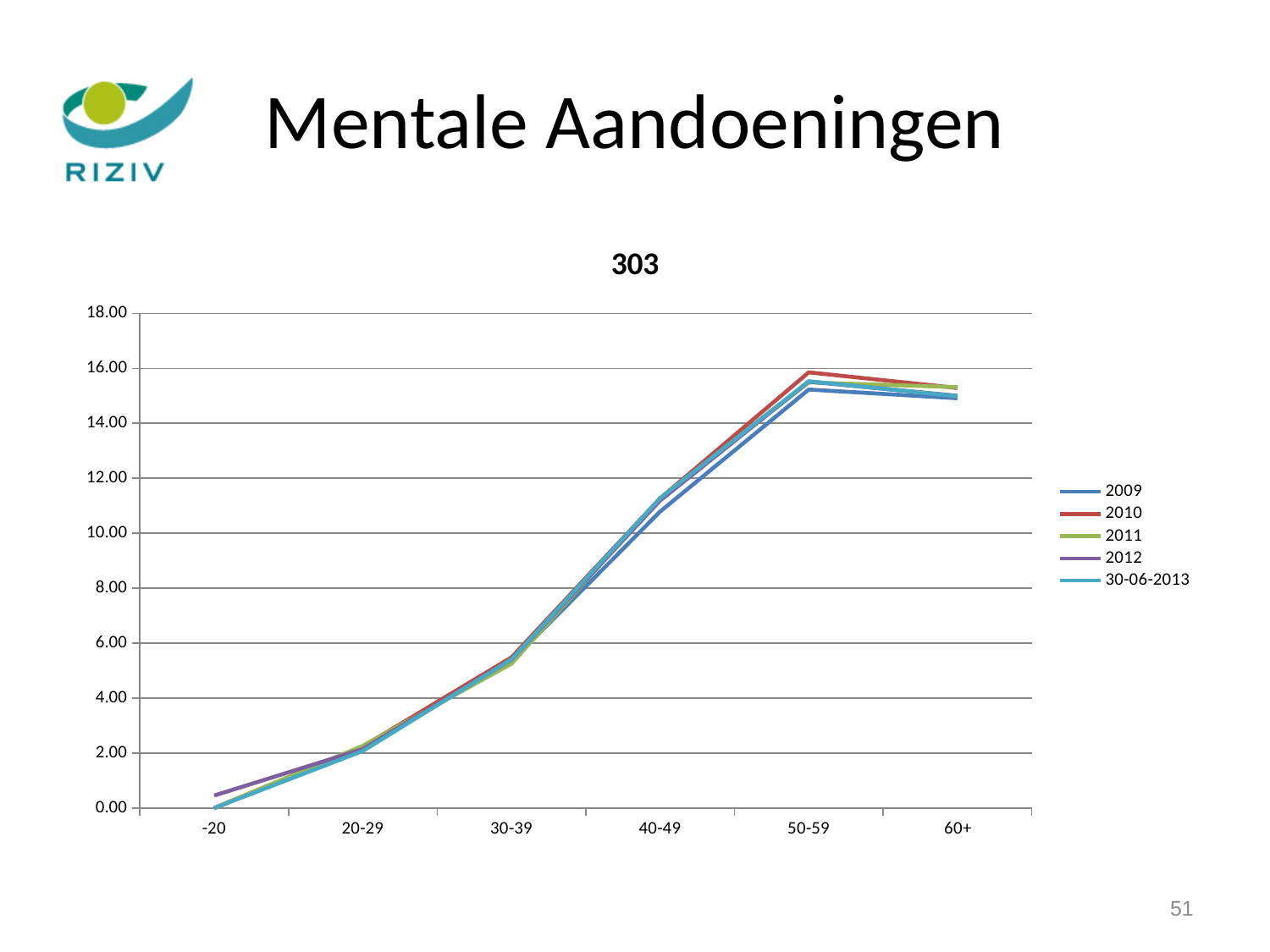
What kind of chart is shown on the slide? line chart What is the title of the chart? 303 How many series does the legend list? 5 How many age categories are shown on the x axis? 6 Which series is listed last in the legend? 30-06-2013 Do the values rise or fall along the x axis from -20 to 50-59? rise For the 2010 series, which age group has the highest value? 50-59 Is the value for 2009 at -20 greater or less than 2.00? less Is the value for 2010 at 40-49 greater or less than 10.00? greater Is the value for 2010 at 50-59 greater or less than 14.00? greater For the 2009 series, which age group has the lowest value? -20 At 50-59, which series has the larger value, 2009 or 2010? 2010